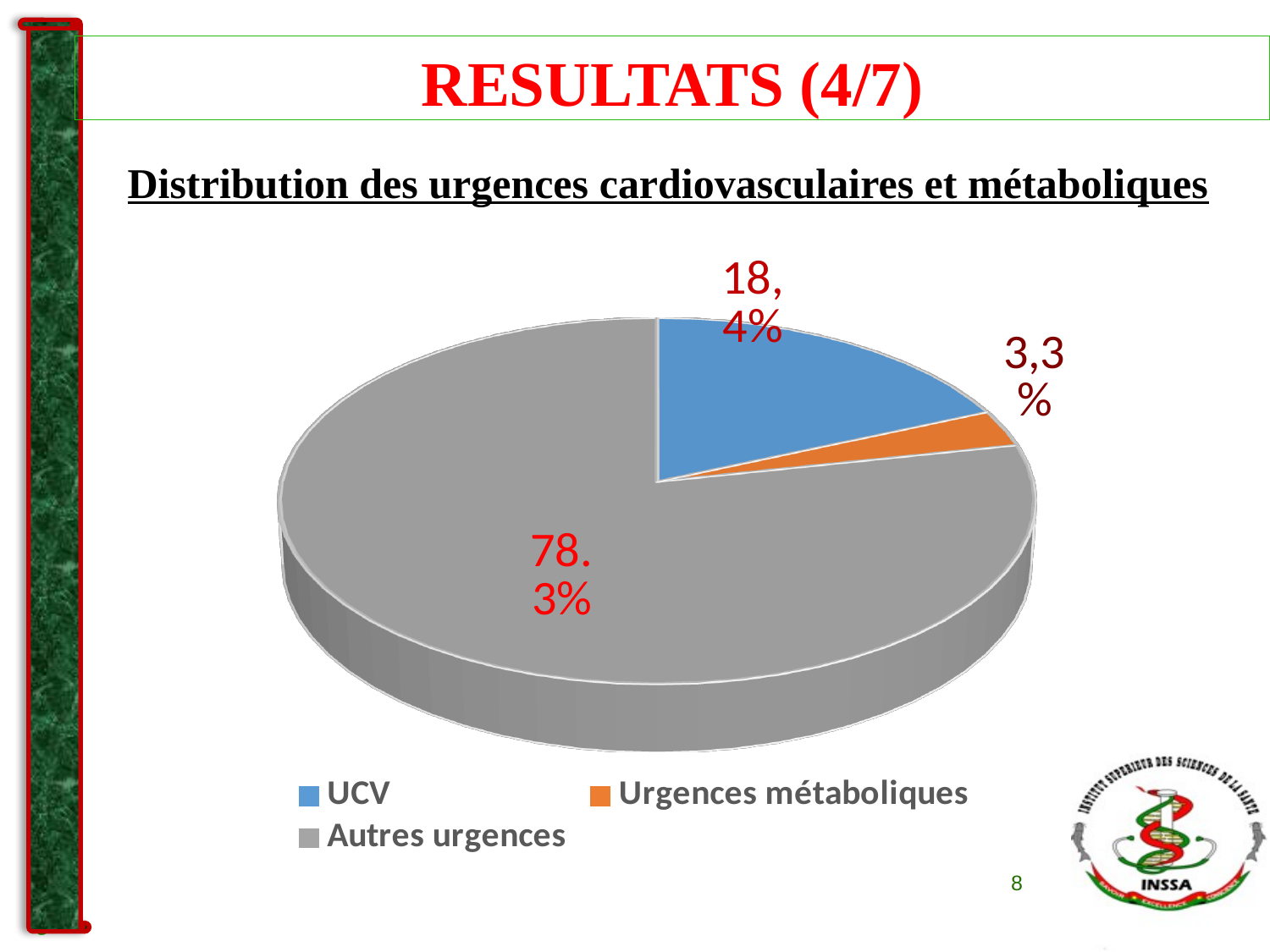
What share of the pie does UCV represent? 18,4% What kind of chart is shown on the slide? pie chart Which colour represents Urgences métaboliques in the legend? orange How many categories does the pie chart show? 3 What is the title of the chart? Distribution des urgences cardiovasculaires et métaboliques What is the difference in percentage points between the UCV slice and the Urgences métaboliques slice? 15,1 Which is larger, the slice for UCV or the slice for Urgences métaboliques? UCV Which category has the largest slice of the pie? Autres urgences What share of the pie does Urgences métaboliques represent? 3,3% What share of the pie does Autres urgences represent? 78.3% Which category has the smallest slice of the pie? Urgences métaboliques